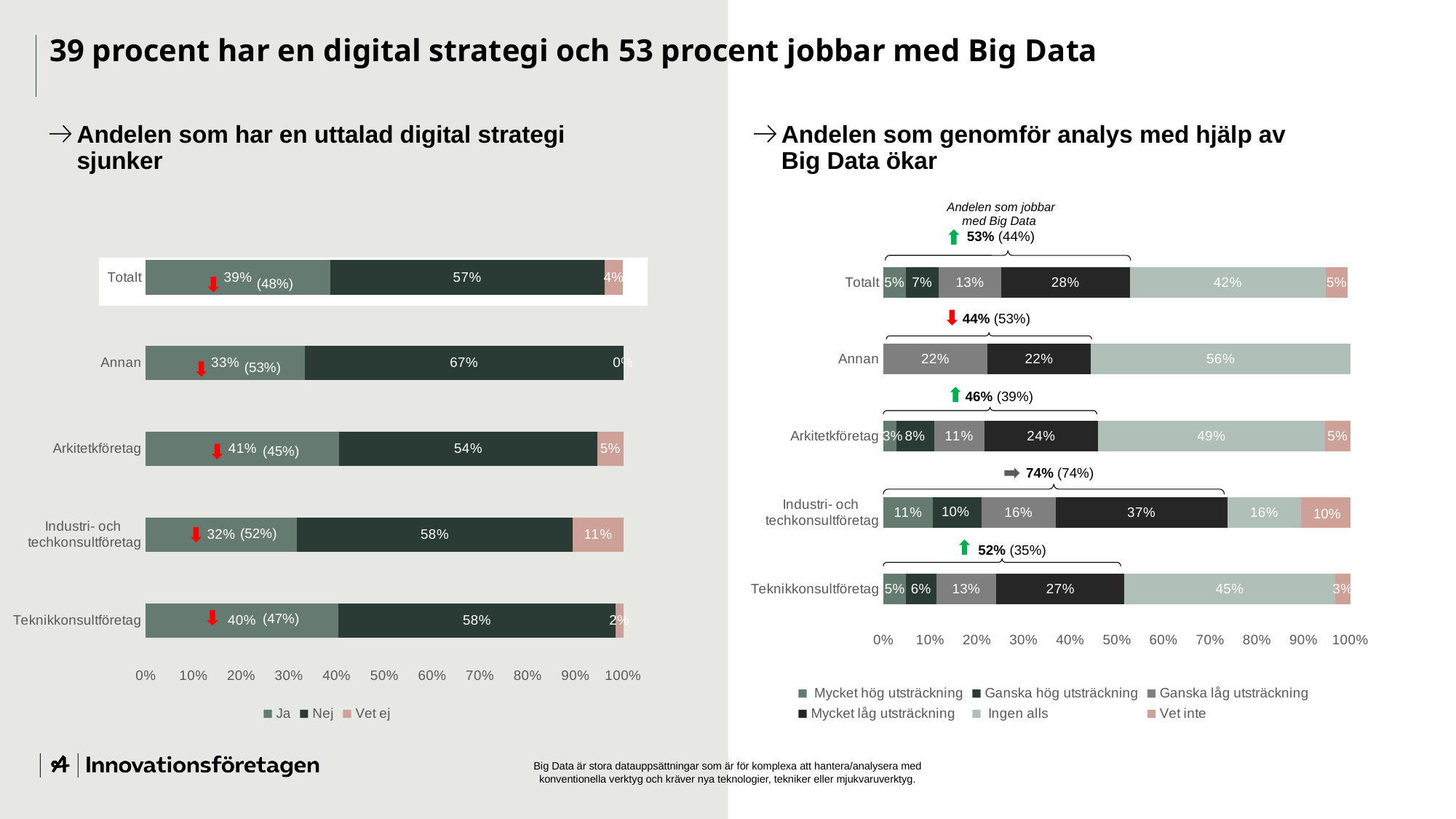
In the left chart (Andelen som har en uttalad digital strategi sjunker), what is the 'Nej' value for Annan? 67% In the left chart (Andelen som har en uttalad digital strategi sjunker), what is the difference between the 'Nej' and 'Ja' values for Totalt? 18% What kind of chart is the right chart (Andelen som genomför analys med hjälp av Big Data ökar)? Stacked bar chart In the left chart (Andelen som har en uttalad digital strategi sjunker), how many series does the legend list? 3 In the left chart (Andelen som har en uttalad digital strategi sjunker), which category has the highest 'Vet ej' value? Industri- och techkonsultföretag In the right chart (Andelen som genomför analys med hjälp av Big Data ökar), what is the 'Ingen alls' value for Annan? 56% In the right chart (Andelen som genomför analys med hjälp av Big Data ökar), which category has the highest 'Mycket hög utsträckning' value? Industri- och techkonsultföretag In the right chart (Andelen som genomför analys med hjälp av Big Data ökar), is the 'Ingen alls' value for Arkitektföretag larger or smaller than that for Teknikkonsultföretag? larger In the left chart (Andelen som har en uttalad digital strategi sjunker), what is the 'Ja' value for Totalt? 39% In the right chart (Andelen som genomför analys med hjälp av Big Data ökar), how many series does the legend list? 6 In the left chart (Andelen som har en uttalad digital strategi sjunker), which category has the highest 'Ja' value? Arkitetkföretag In the right chart (Andelen som genomför analys med hjälp av Big Data ökar), what is the 'Mycket låg utsträckning' value for Industri- och techkonsultföretag? 37%